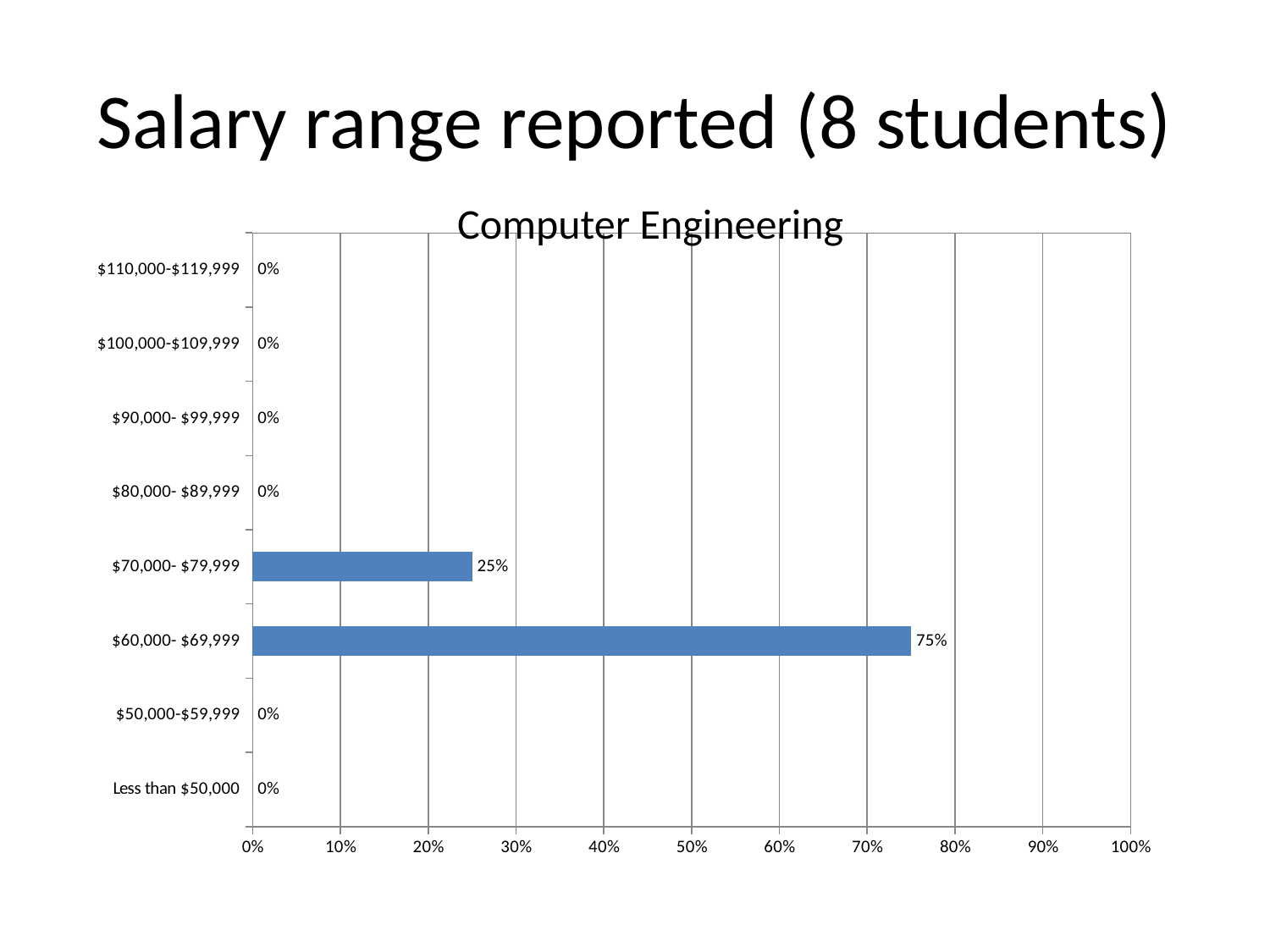
Which salary range has the highest percentage of students? $60,000- $69,999 What is the difference between the percentages for the $60,000- $69,999 and $70,000- $79,999 ranges? 50% What percentage of students reported a salary in the $60,000- $69,999 range? 75% What is the value shown for the $80,000- $89,999 salary range? 0% What type of chart is shown on the slide? Bar chart Is the value for $60,000- $69,999 greater or less than 50%? greater How many salary ranges have a value of 0%? 6 Which is larger, the value for $60,000- $69,999 or the value for $70,000- $79,999? $60,000- $69,999 Is the value for $70,000- $79,999 greater or less than 30%? less How many salary range categories are shown on the chart? 8 What is the title of the chart? Computer Engineering What percentage of students reported a salary in the $70,000- $79,999 range? 25%